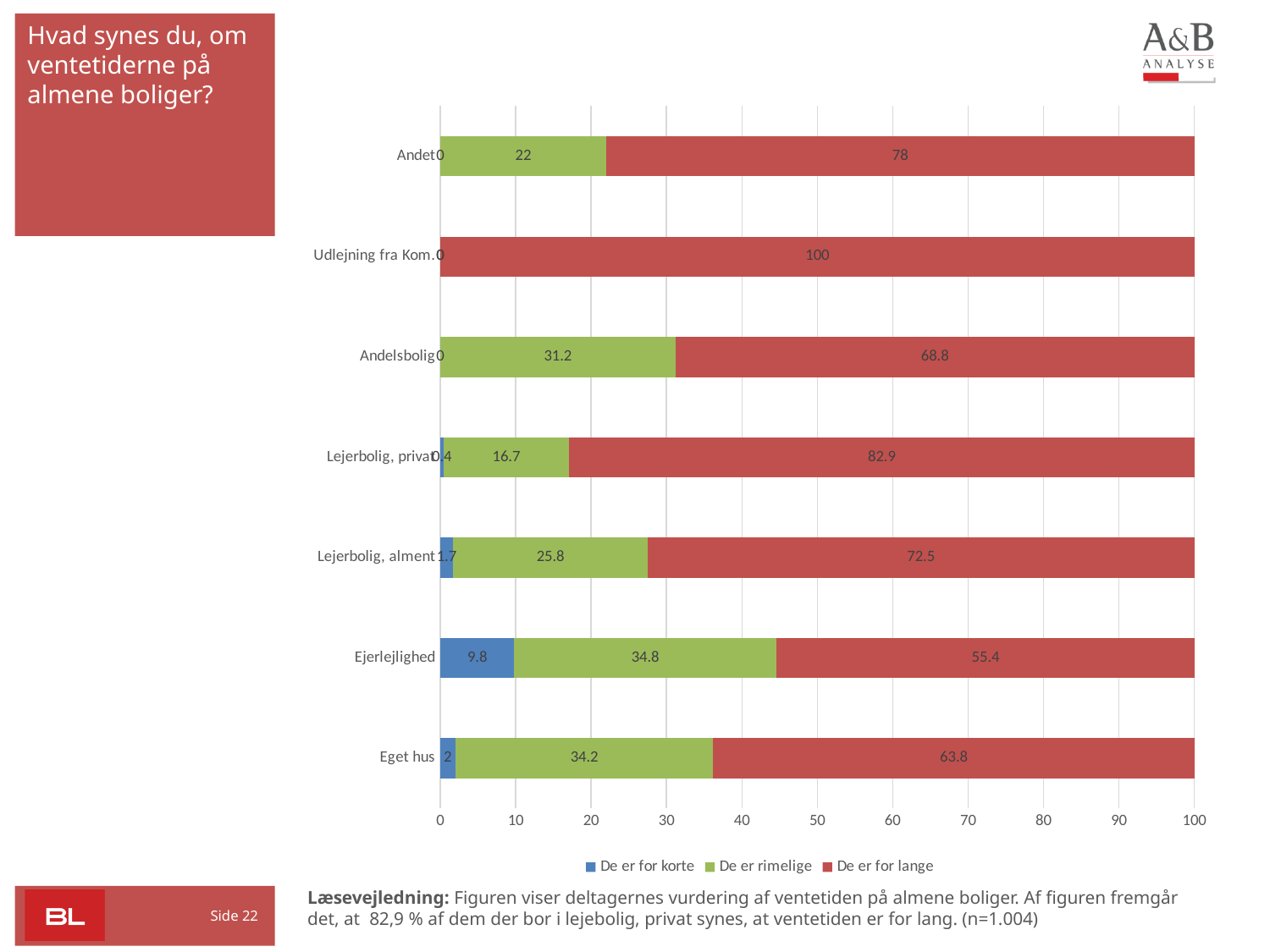
What is the value of 'De er rimelige' for 'Ejerlejlighed'? 34.8 Which is larger: the 'De er rimelige' value for 'Andelsbolig' or for 'Lejerbolig, alment'? Andelsbolig What is the value of 'De er for lange' for 'Udlejning fra Kom.'? 100 Which category has the lowest value for 'De er for lange'? Ejerlejlighed How many series does the legend list? 3 What is the value of 'De er for lange' for 'Lejerbolig, privat'? 82.9 What is the value of 'De er for korte' for 'Lejerbolig, alment'? 1.7 What kind of chart is shown on the slide? Stacked bar chart What is the difference between the 'De er for lange' values for 'Andet' and 'Eget hus'? 14.2 Which series is shown in red? De er for lange How many categories are shown on the chart? 7 Which category has the highest value for 'De er for korte'? Ejerlejlighed